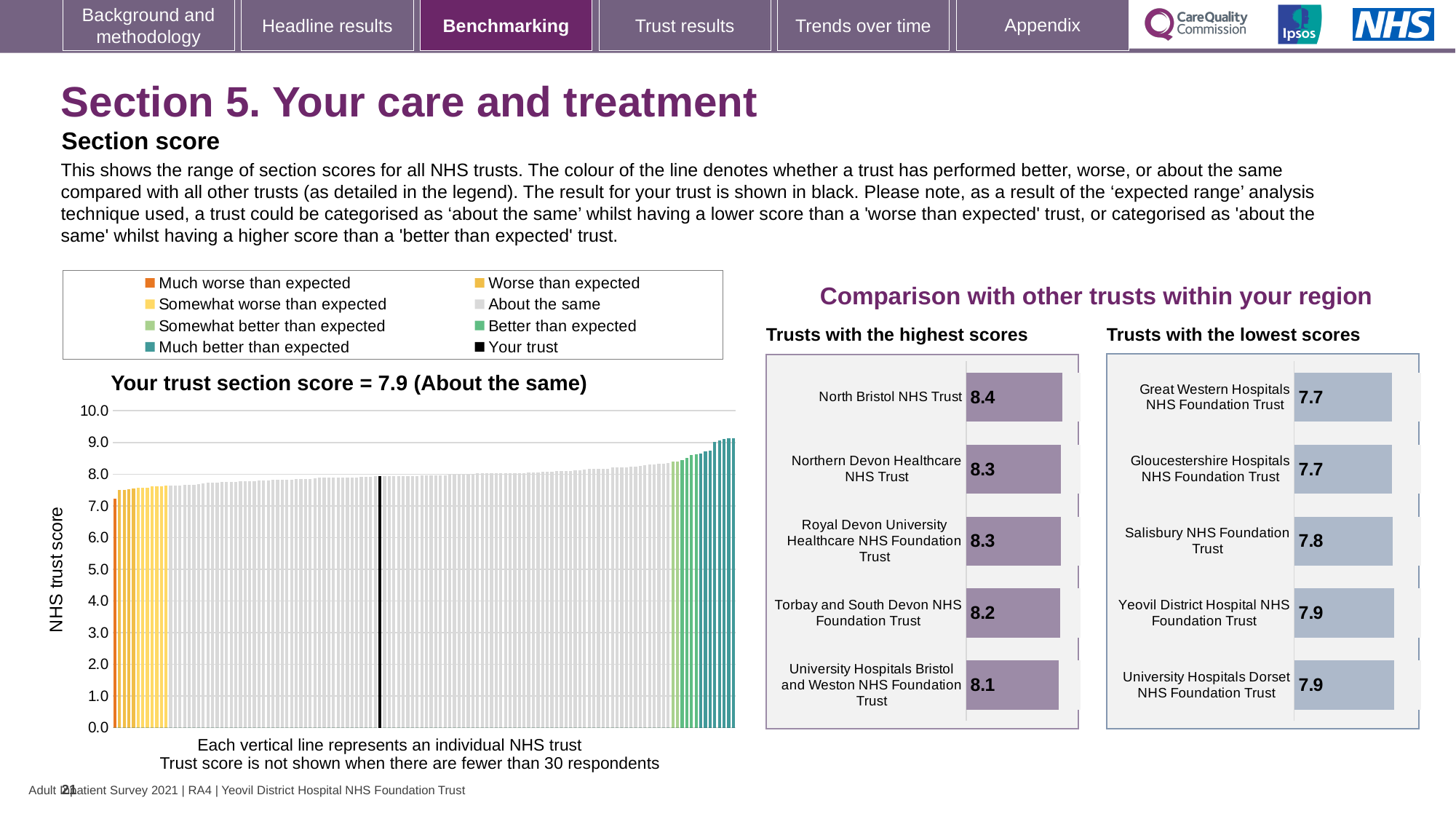
In the 'Trusts with the lowest scores' chart, which has the larger score: Salisbury NHS Foundation Trust or Great Western Hospitals NHS Foundation Trust? Salisbury NHS Foundation Trust In the 'Trusts with the highest scores' chart, what is the difference between the scores of North Bristol NHS Trust and University Hospitals Bristol and Weston NHS Foundation Trust? 0.3 In the 'Trusts with the highest scores' chart, which trust has the highest score? North Bristol NHS Trust How many trusts are shown in the 'Trusts with the lowest scores' chart? 5 In the 'Your trust section score' chart, what kind of chart is it? bar chart In the 'Your trust section score' chart, do the trust scores rise or fall from left to right? rise In the 'Your trust section score' chart, is the value of the leftmost (lowest) bar greater or less than 8.0? less In the 'Trusts with the highest scores' chart, what is the score for Torbay and South Devon NHS Foundation Trust? 8.2 In the 'Trusts with the lowest scores' chart, what is the score for Salisbury NHS Foundation Trust? 7.8 In the 'Your trust section score' chart, what is the section score for your trust? 7.9 How many entries does the legend above the 'Your trust section score' chart list? 8 In the 'Your trust section score' chart, is the value of the rightmost (highest) bar greater or less than 8.0? greater